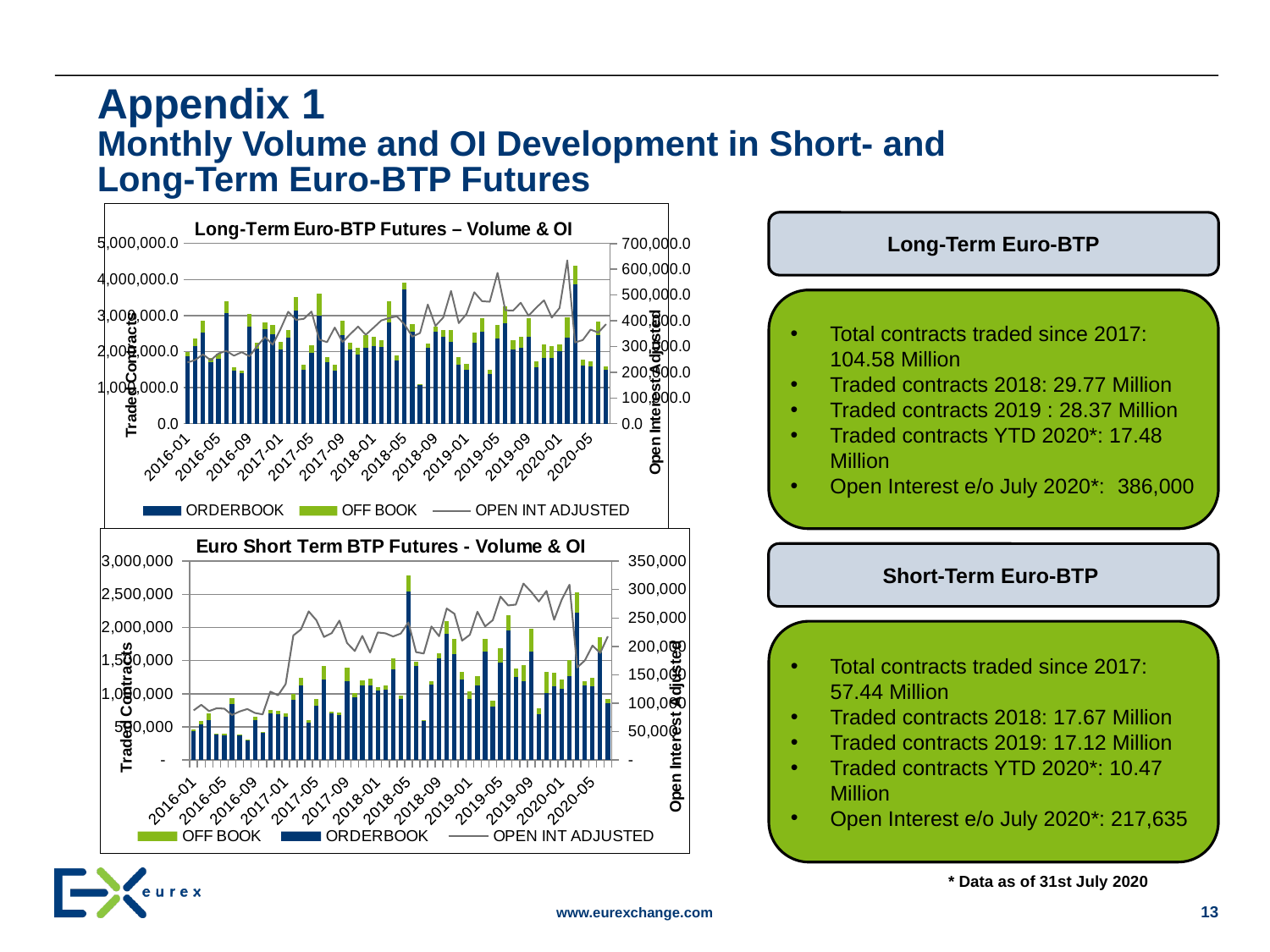
In the top chart, 'Long-Term Euro-BTP Futures – Volume & OI', is the total traded contracts bar for 2016-01 greater or less than 3,000,000.0? less In the bottom chart, 'Euro Short Term BTP Futures - Volume & OI', is the tallest traded contracts bar greater or less than 2,500,000? greater In the top chart, 'Long-Term Euro-BTP Futures – Volume & OI', is the tallest traded contracts bar greater or less than 4,000,000.0? greater What kind of chart is the top chart, 'Long-Term Euro-BTP Futures – Volume & OI'? Stacked bar chart with a line How many series does the legend of the top chart, 'Long-Term Euro-BTP Futures – Volume & OI', list? 3 In the bottom chart, 'Euro Short Term BTP Futures - Volume & OI', does the OPEN INT ADJUSTED line overall rise or fall from 2016-01 to 2020-05? rise How many series does the legend of the bottom chart, 'Euro Short Term BTP Futures - Volume & OI', list? 3 In the bottom chart, 'Euro Short Term BTP Futures - Volume & OI', what colour are the OFF BOOK bars? Green In the top chart, 'Long-Term Euro-BTP Futures – Volume & OI', does the OPEN INT ADJUSTED line overall rise or fall from 2016-01 to 2020-05? rise In the top chart, 'Long-Term Euro-BTP Futures – Volume & OI', which series is drawn as a line? OPEN INT ADJUSTED